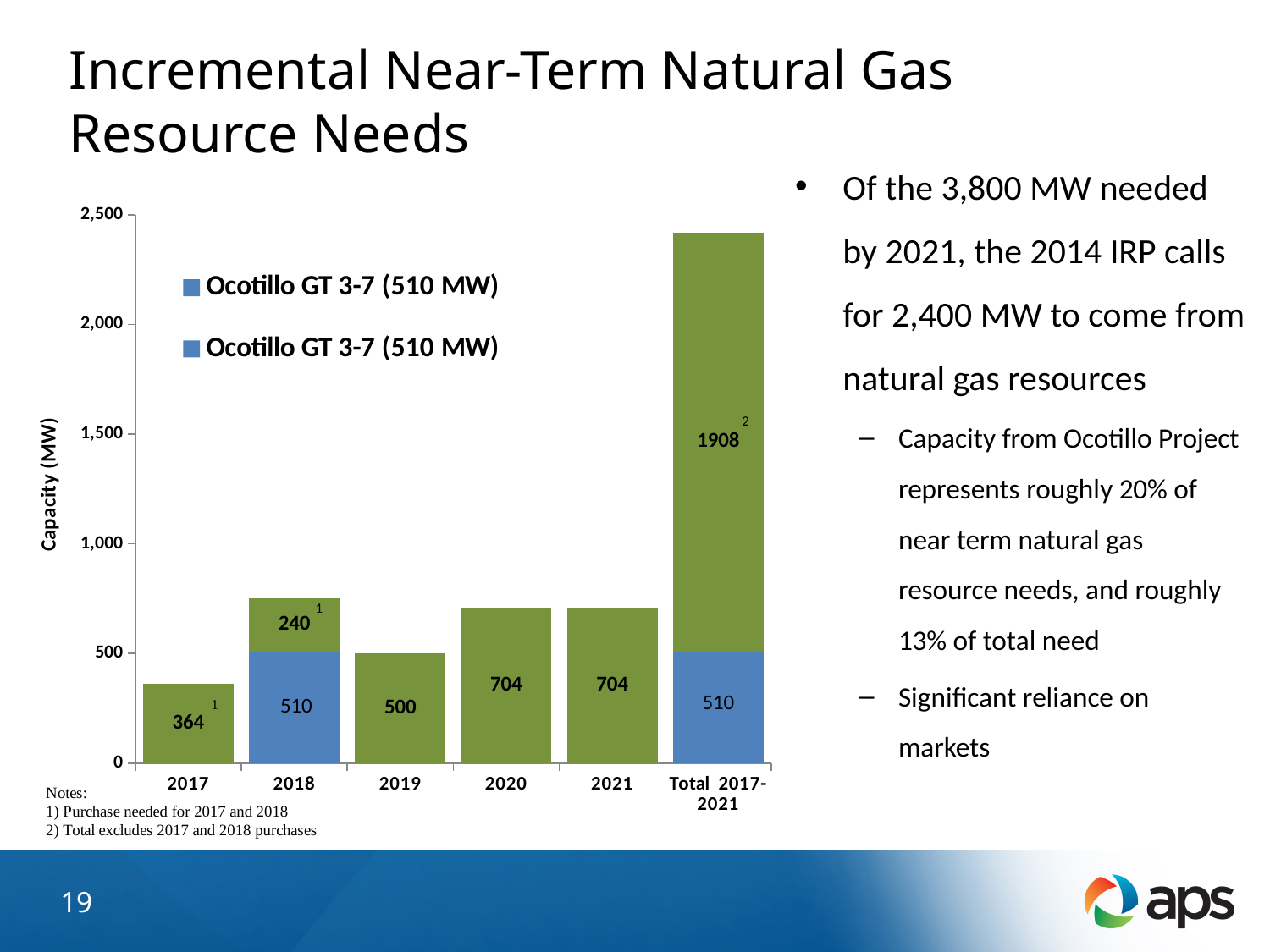
What is the value of the blue segment for 2018? 510 What is the value shown for 2020? 704 What is the total height of the stacked bar for 2018? 750 What is the value of the green segment for 2017? 364 How many categories are shown on the x axis? 6 What is the value of the green segment for 2018? 240 Which category has the tallest bar? Total 2017-2021 What is the difference between the values for 2020 and 2019? 204 What is the total height of the stacked bar for Total 2017-2021? 2418 What is the title of the y axis? Capacity (MW) What is the value of the green segment for Total 2017-2021? 1908 Which category has the shortest bar? 2017